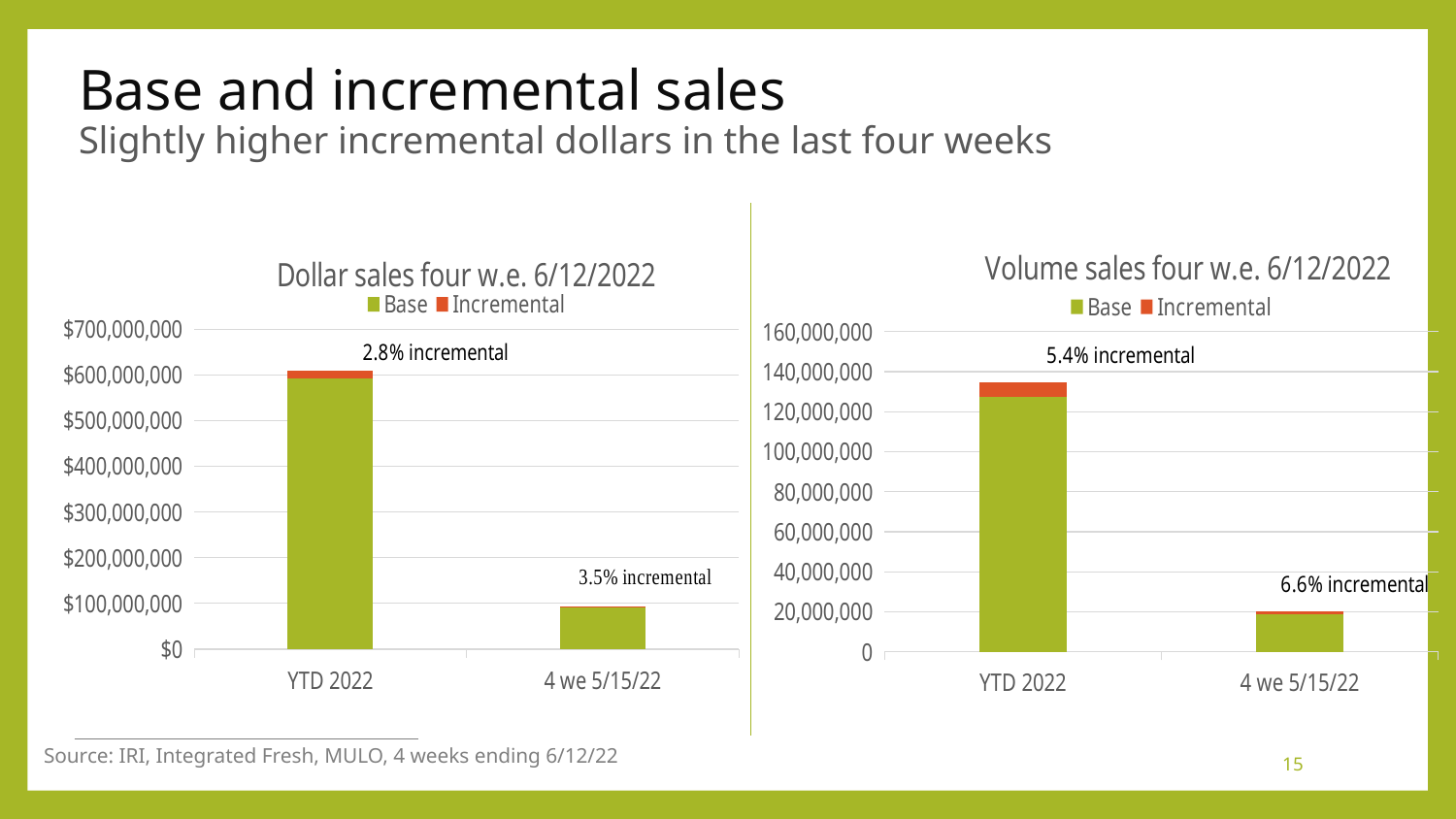
In the 'Volume sales four w.e. 6/12/2022' chart, what incremental percentage is labelled for YTD 2022? 5.4% incremental What type of chart is the 'Dollar sales four w.e. 6/12/2022' chart? Stacked bar chart How many categories are shown on the x axis of the 'Dollar sales four w.e. 6/12/2022' chart? 2 In the 'Dollar sales four w.e. 6/12/2022' chart, is the total bar for 4 we 5/15/22 greater or less than $100,000,000? less In the 'Volume sales four w.e. 6/12/2022' chart, is the total bar for YTD 2022 greater or less than 120,000,000? greater What colour represents the Incremental series in the legends of both charts? Orange-red In the 'Dollar sales four w.e. 6/12/2022' chart, what incremental percentage is labelled for YTD 2022? 2.8% incremental In the 'Dollar sales four w.e. 6/12/2022' chart, which category has the taller total bar, YTD 2022 or 4 we 5/15/22? YTD 2022 How many series does the legend of the 'Volume sales four w.e. 6/12/2022' chart list? 2 In the 'Volume sales four w.e. 6/12/2022' chart, is the total bar for 4 we 5/15/22 greater or less than 40,000,000? less In the 'Volume sales four w.e. 6/12/2022' chart, what incremental percentage is labelled for 4 we 5/15/22? 6.6% incremental In the 'Dollar sales four w.e. 6/12/2022' chart, what incremental percentage is labelled for 4 we 5/15/22? 3.5% incremental